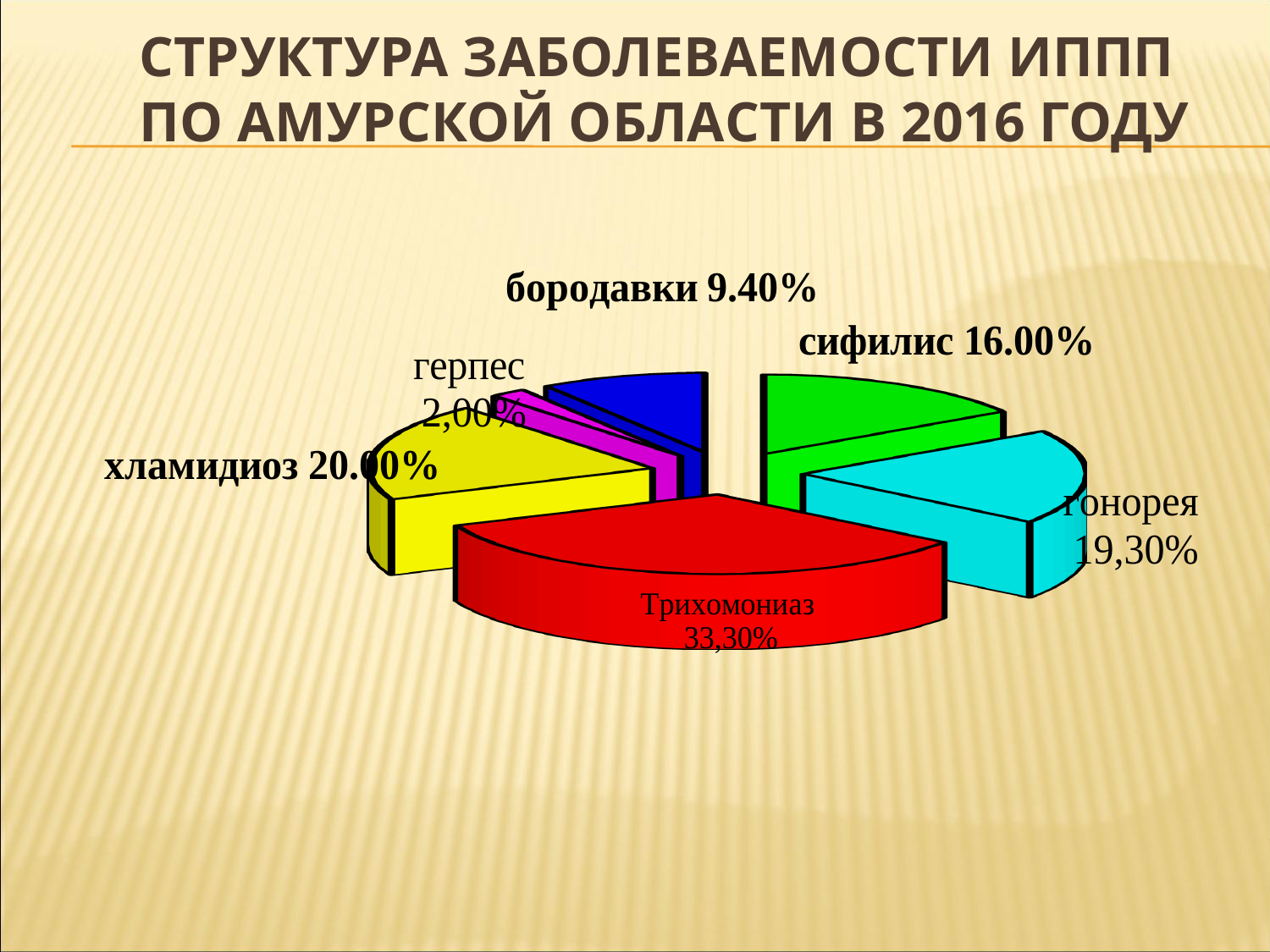
What colour is the slice for Трихомониаз? red Which category has the largest share of the pie? Трихомониаз What is the value shown for гонорея? 19,30% What is the value shown for герпес? 2,00% What kind of chart is shown on the slide? pie chart Which category has the smallest share of the pie? герпес What share of the pie is Трихомониаз? 33,30% What is the value shown for бородавки? 9.40% Which is larger, the share for хламидиоз or the share for гонорея? хламидиоз What is the difference between the shares for сифилис and бородавки? 6.60% What is the value shown for сифилис? 16.00% How many slices does the pie chart have? 6